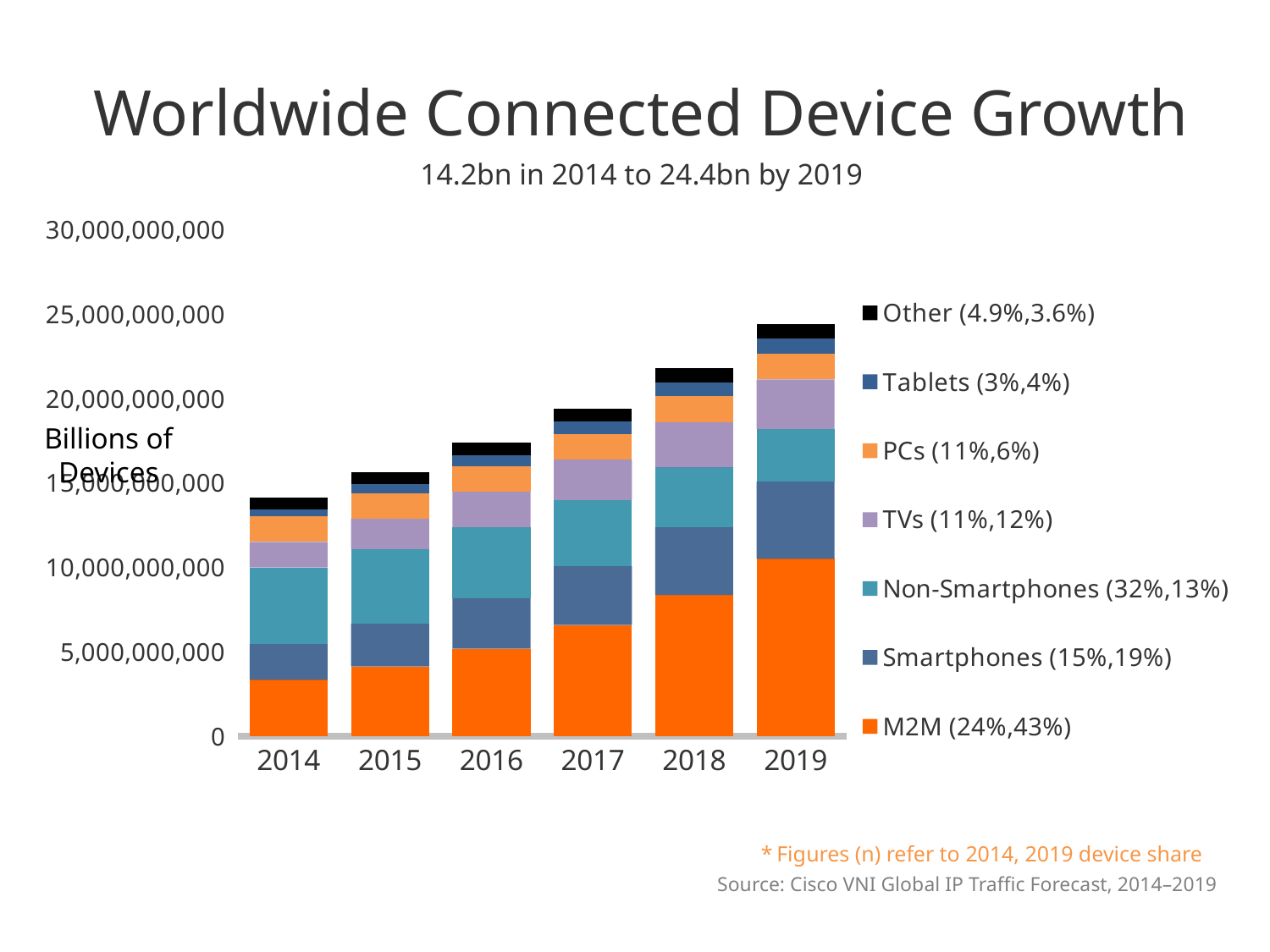
What kind of chart is shown on the slide? Stacked bar chart Is the total for 2014 greater or less than 15,000,000,000? less How many series does the chart's legend list? 7 How many years are shown on the x axis of the chart? 6 Is the total for 2018 greater or less than 20,000,000,000? greater Do the total connected devices rise or fall from 2014 to 2019? Rise Which year has a larger total of connected devices, 2016 or 2018? 2018 According to the legend, what is the 2019 device share for M2M? 43% According to the subtitle, what is the total number of connected devices by 2019? 24.4bn Which year has the lowest total of connected devices? 2014 Is the M2M value for 2014 greater or less than 5,000,000,000? less Which year has the highest total of connected devices? 2019